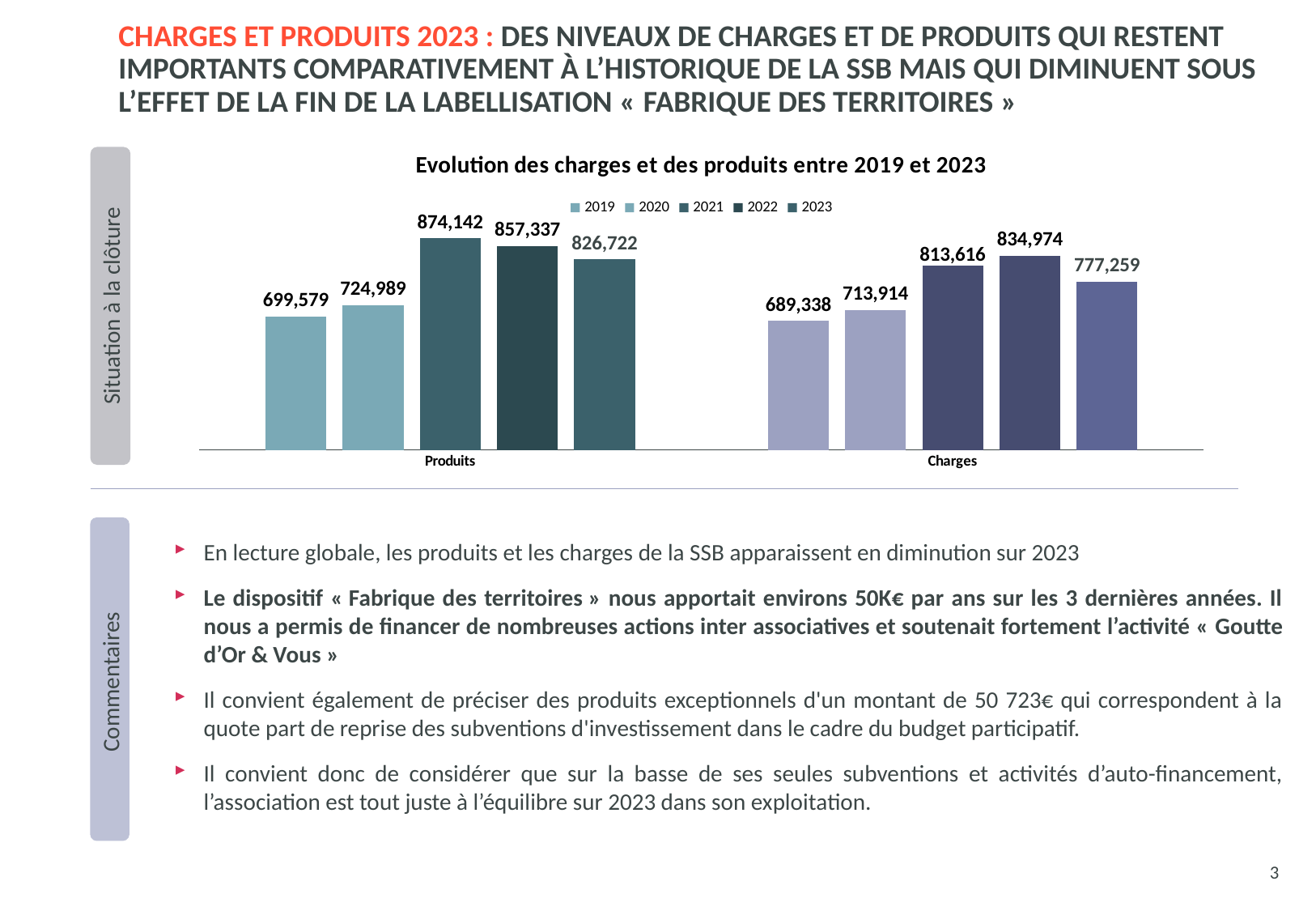
What is the difference between Produits and Charges in 2023? 49,463 Which is larger in 2022, Produits or Charges? Produits What is the difference between Produits in 2021 and Produits in 2020? 149,153 How many categories are shown on the x axis? 2 What is the value of Produits for 2021? 874,142 What is the value of Charges for 2023? 777,259 What is the value of Produits for 2019? 699,579 What is the title of the chart? Evolution des charges et des produits entre 2019 et 2023 Which year has the lowest value for Produits? 2019 How many series does the legend list? 5 What kind of chart is shown on the slide? Bar chart Which year has the highest value for Charges? 2022